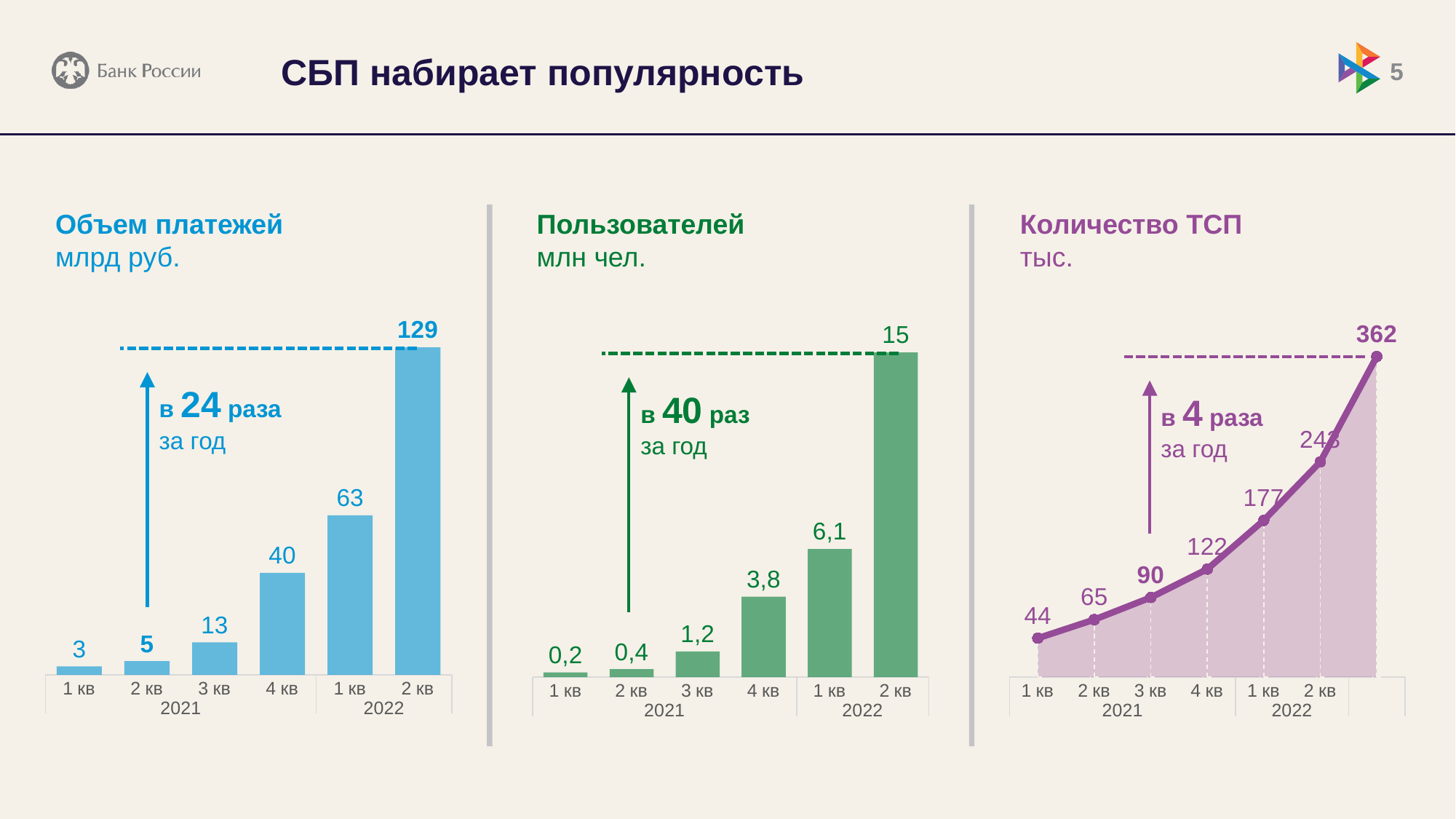
In the 'Количество ТСП' chart, what is the value for 1 кв 2022? 177 In the 'Пользователей' chart, what is the value for 4 кв 2021? 3,8 In the 'Объем платежей' chart, which quarter has the lowest value? 1 кв 2021 In the 'Объем платежей' chart, what is the value for 4 кв 2021? 40 In the 'Пользователей' chart, which quarter has the highest value? 2 кв 2022 In the 'Количество ТСП' chart, what is the difference between 4 кв 2021 and 3 кв 2021? 32 What kind of chart is the 'Количество ТСП' chart? area and line chart (line with shaded area beneath) In the 'Пользователей' chart, how many quarters are plotted? 6 What kind of chart is the 'Пользователей' chart? bar chart In the 'Количество ТСП' chart, do the values rise or fall from 1 кв 2021 to 2 кв 2022? rise In the 'Объем платежей' chart, what is the difference between 2 кв 2022 and 1 кв 2022? 66 In the 'Объем платежей' chart, what is the value for 2 кв 2022? 129